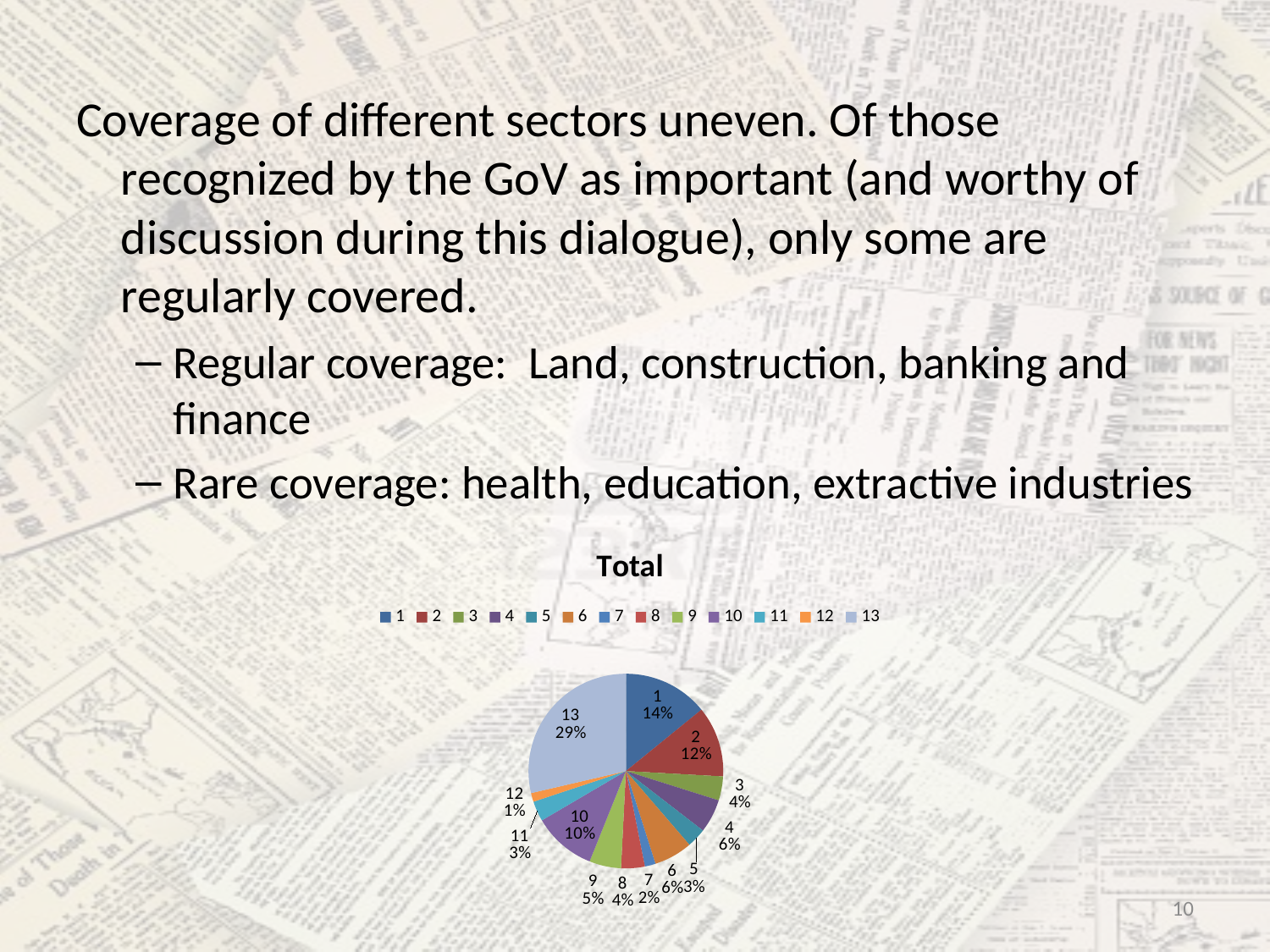
Which is larger, slice 2 or slice 4? slice 2 How many entries does the legend list? 13 Which slice is the smallest? 12 How many slices does the pie chart have? 13 What is the value shown for slice 10? 10% What share of the pie does slice 13 represent? 29% What type of chart is shown on the slide? pie chart What is the value shown for slice 7? 2% What is the title of the chart? Total What is the value shown for slice 1? 14% What is the difference in percentage points between slice 13 and slice 1? 15 Which slice is the largest? 13